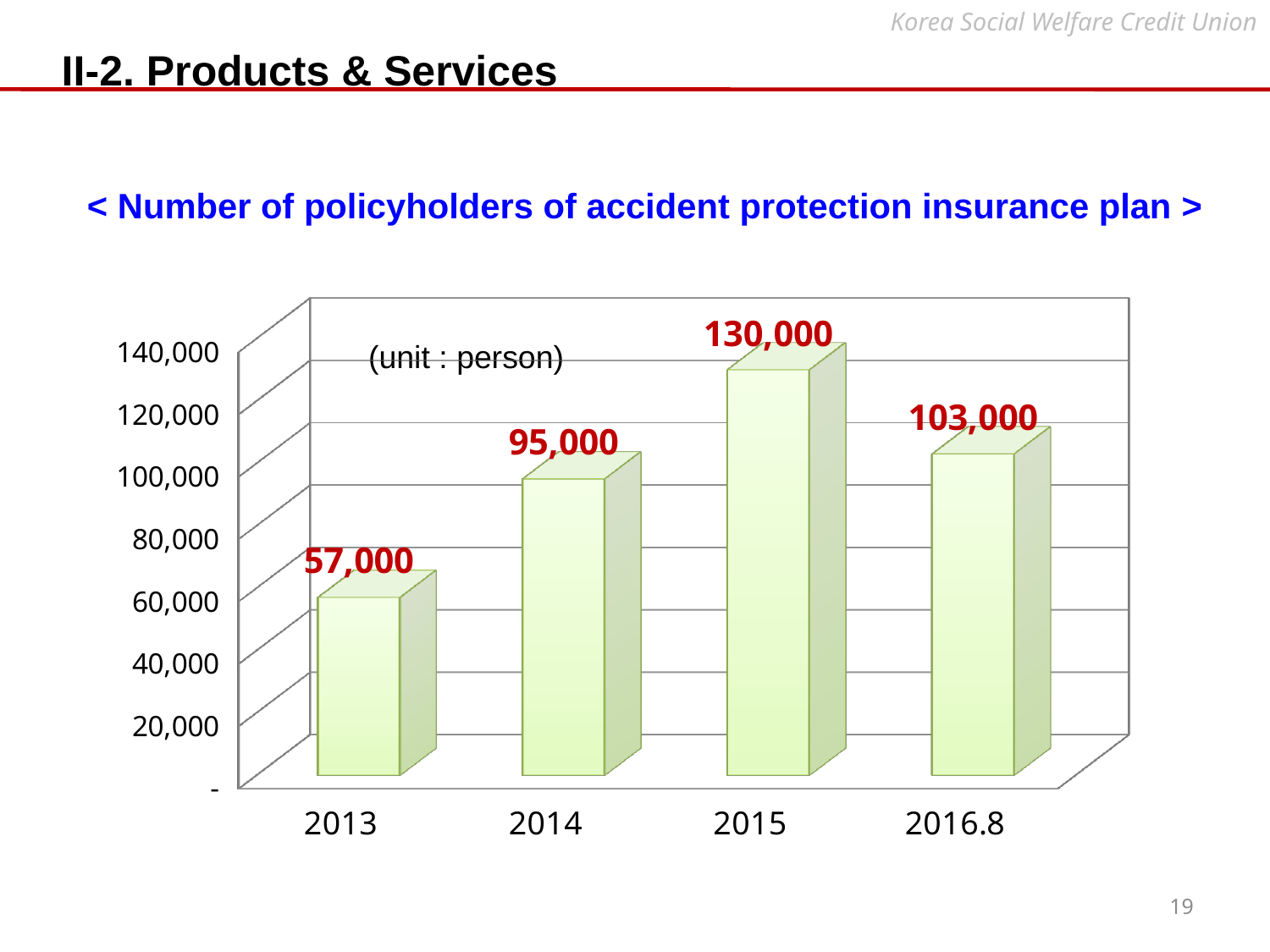
Which year has the lowest number of policyholders? 2013 How many years are shown on the x axis? 4 What is the number of policyholders in 2013? 57,000 What is the number of policyholders in 2014? 95,000 What kind of chart is shown on the slide? Bar chart Which has more policyholders, 2014 or 2016.8? 2016.8 What is the difference in policyholders between 2015 and 2014? 35,000 What is the number of policyholders in 2016.8? 103,000 What is the difference in policyholders between 2016.8 and 2013? 46,000 What unit is stated for the values in the chart? person What is the number of policyholders in 2015? 130,000 Which year has the highest number of policyholders? 2015